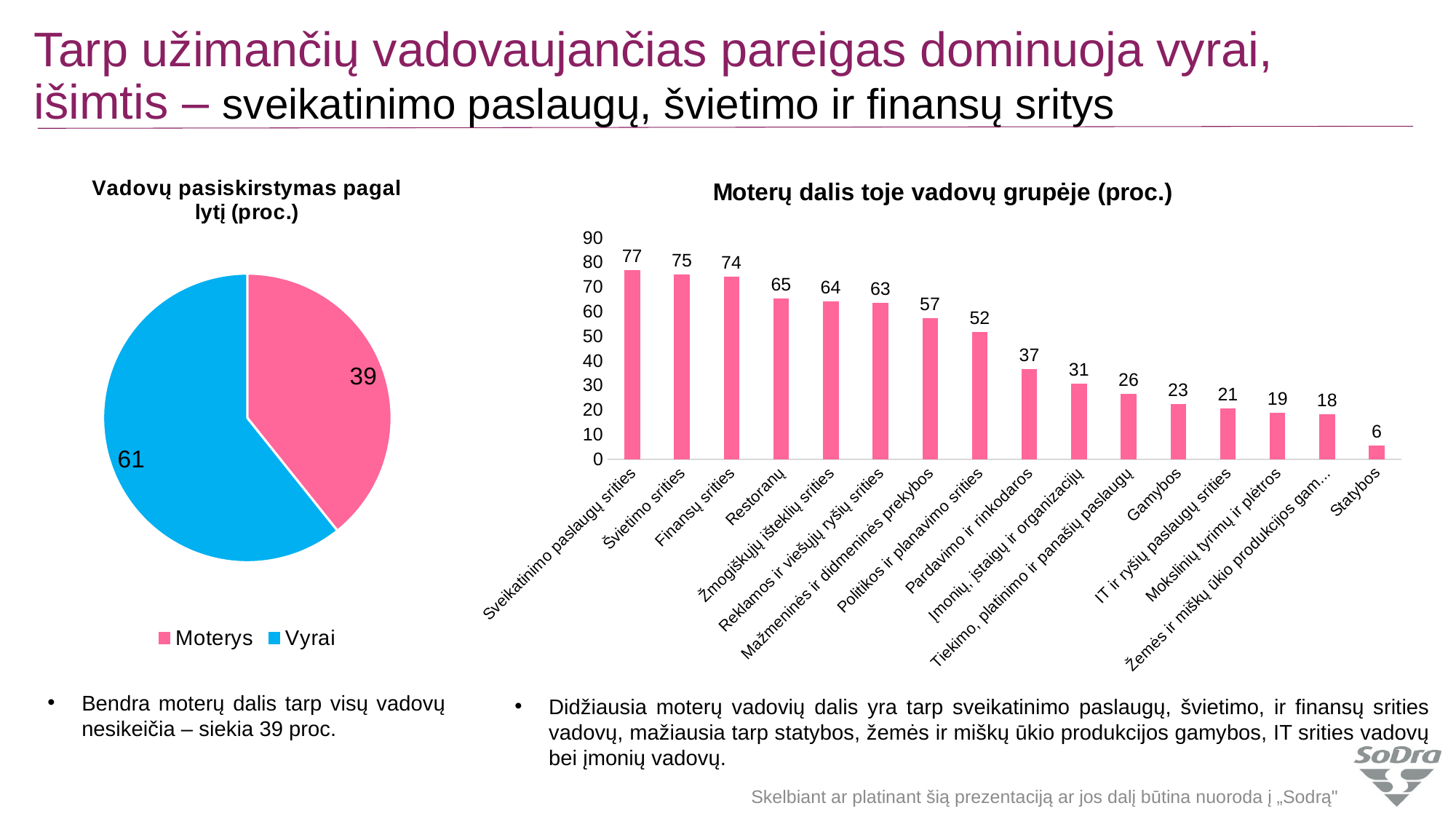
In the chart 'Moterų dalis toje vadovų grupėje (proc.)', do the values rise or fall from left to right? fall In the chart 'Moterų dalis toje vadovų grupėje (proc.)', what is the value for Restoranų? 65 In the chart 'Moterų dalis toje vadovų grupėje (proc.)', what is the value for Sveikatinimo paslaugų srities? 77 In the chart 'Moterų dalis toje vadovų grupėje (proc.)', which category has the highest value? Sveikatinimo paslaugų srities What kind of chart is 'Moterų dalis toje vadovų grupėje (proc.)'? bar chart In the chart 'Moterų dalis toje vadovų grupėje (proc.)', which is larger: Mažmeninės ir didmeninės prekybos or Įmonių, įstaigų ir organizacijų? Mažmeninės ir didmeninės prekybos How many categories are shown in the chart 'Moterų dalis toje vadovų grupėje (proc.)'? 16 In the chart 'Moterų dalis toje vadovų grupėje (proc.)', what is the difference between Politikos ir planavimo srities and Pardavimo ir rinkodaros? 15 In the chart 'Moterų dalis toje vadovų grupėje (proc.)', what is the value for Gamybos? 23 In the chart 'Moterų dalis toje vadovų grupėje (proc.)', which category has the lowest value? Statybos How many series does the legend of the pie chart 'Vadovų pasiskirstymas pagal lytį (proc.)' list? 2 In the pie chart 'Vadovų pasiskirstymas pagal lytį (proc.)', what is the value for Vyrai? 61